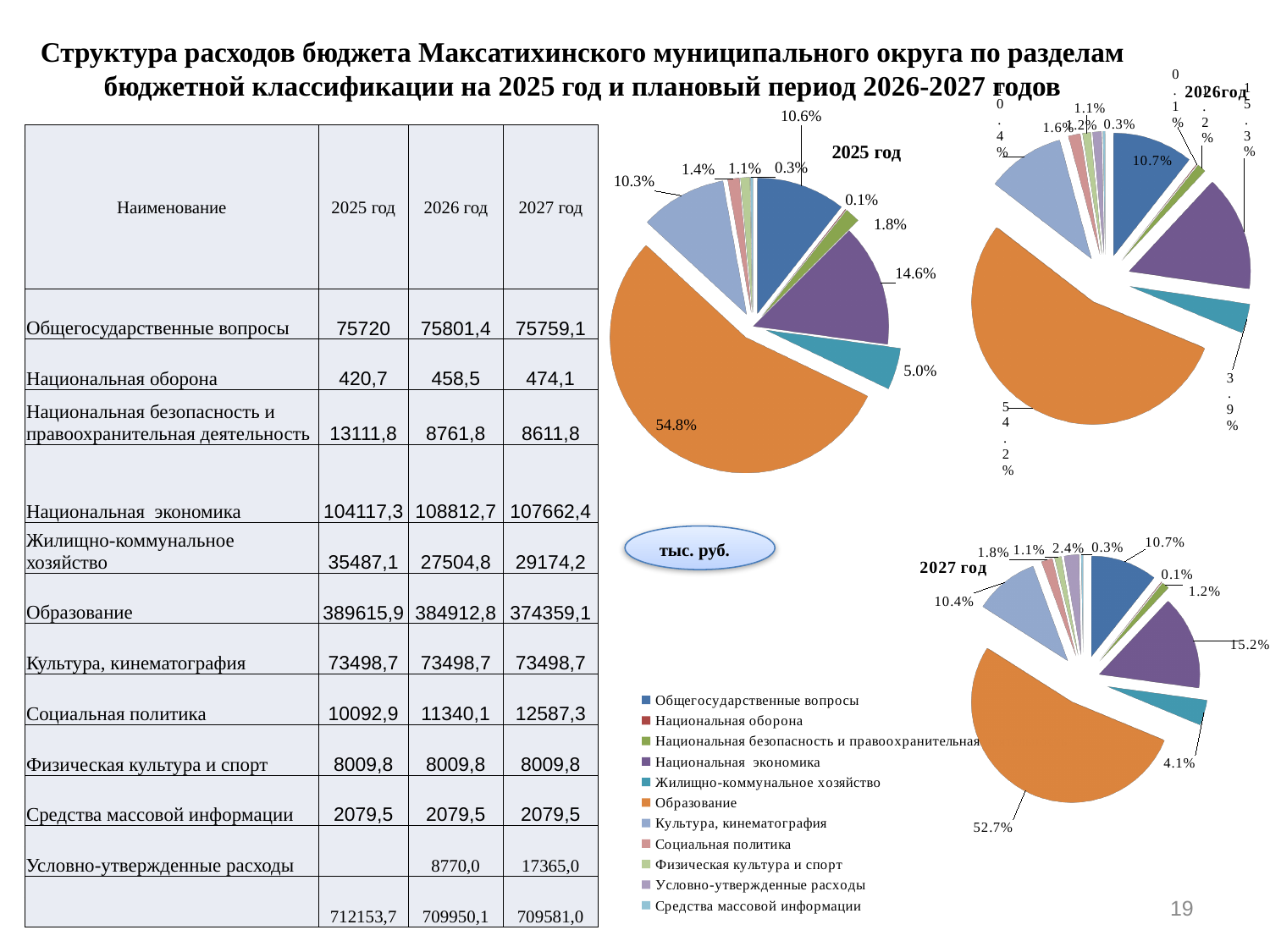
In the 2027 год pie chart, what share does Образование have? 52.7% In the 2026 год pie chart, what is the share for Общегосударственные вопросы? 10.7% In the 2025 год pie chart, what is the share for Национальная экономика? 14.6% In the 2025 год pie chart, which category has the largest share? Образование In the 2027 год pie chart, what is the share for Условно-утвержденные расходы? 2.4% In the 2027 год pie chart, what is the share for Национальная экономика? 15.2% In the 2025 год pie chart, what is the difference between the shares of Образование and Национальная экономика? 40.2% What kind of chart is used for the 2025 год chart? pie chart In the 2025 год pie chart, what share does Образование have? 54.8% In the 2027 год pie chart, which is larger: the share for Общегосударственные вопросы or the share for Жилищно-коммунальное хозяйство? Общегосударственные вопросы How many entries does the legend list? 11 In the 2025 год pie chart, what is the share for Жилищно-коммунальное хозяйство? 5.0%